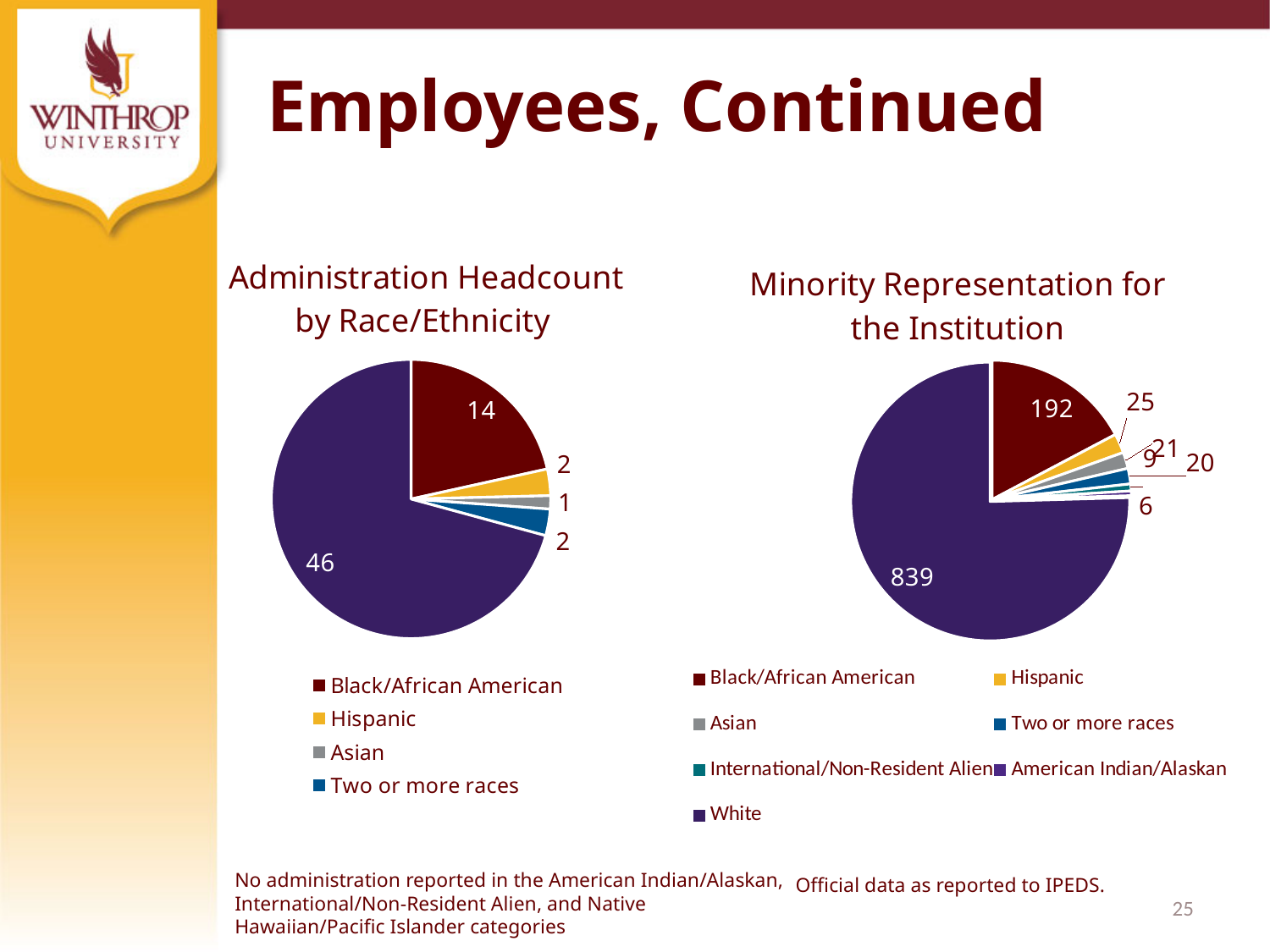
In the 'Minority Representation for the Institution' chart, what is the difference between the White value and the Black/African American value? 647 In the 'Minority Representation for the Institution' chart, what is the value for White? 839 In the 'Administration Headcount by Race/Ethnicity' chart, what is the value for Hispanic? 2 In the 'Administration Headcount by Race/Ethnicity' chart, what is the difference between the Black/African American value and the Asian value? 13 What kind of chart is the 'Administration Headcount by Race/Ethnicity' chart? Pie chart In the 'Minority Representation for the Institution' chart, what is the value for Hispanic? 25 In the 'Administration Headcount by Race/Ethnicity' chart, what is the value for Asian? 1 In the 'Minority Representation for the Institution' chart, what is the value for Black/African American? 192 How many entries does the legend of the 'Minority Representation for the Institution' chart list? 7 In the 'Administration Headcount by Race/Ethnicity' chart, what is the value for Black/African American? 14 How many entries does the legend of the 'Administration Headcount by Race/Ethnicity' chart list? 4 In the 'Administration Headcount by Race/Ethnicity' chart, which is larger: Black/African American or Hispanic? Black/African American